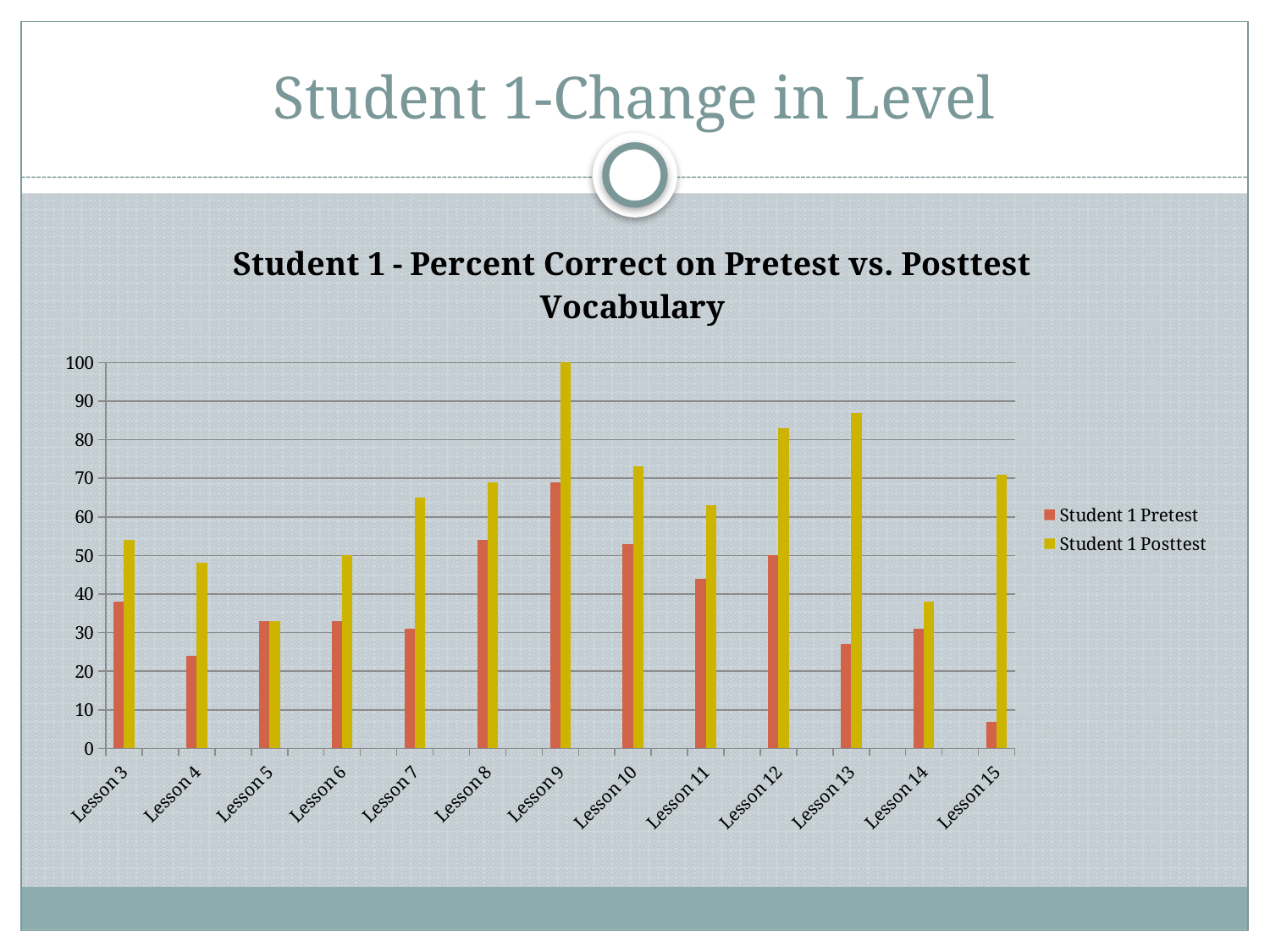
What is the title of the chart? Student 1 - Percent Correct on Pretest vs. Posttest Vocabulary How many lessons are shown on the x axis? 13 What type of chart is shown on the slide? bar chart Which lesson has the highest Student 1 Pretest value? Lesson 9 Which lesson has the highest Student 1 Posttest value? Lesson 9 What is the Student 1 Posttest value for Lesson 9? 100 Is the Student 1 Pretest value for Lesson 3 greater or less than 40? less Is the Student 1 Posttest value for Lesson 13 greater or less than 80? greater Is the Student 1 Pretest value for Lesson 15 greater or less than 10? less For Lesson 13, which is larger: the Student 1 Pretest value or the Student 1 Posttest value? Student 1 Posttest How many series does the legend list? 2 Which lesson has the lowest Student 1 Pretest value? Lesson 15